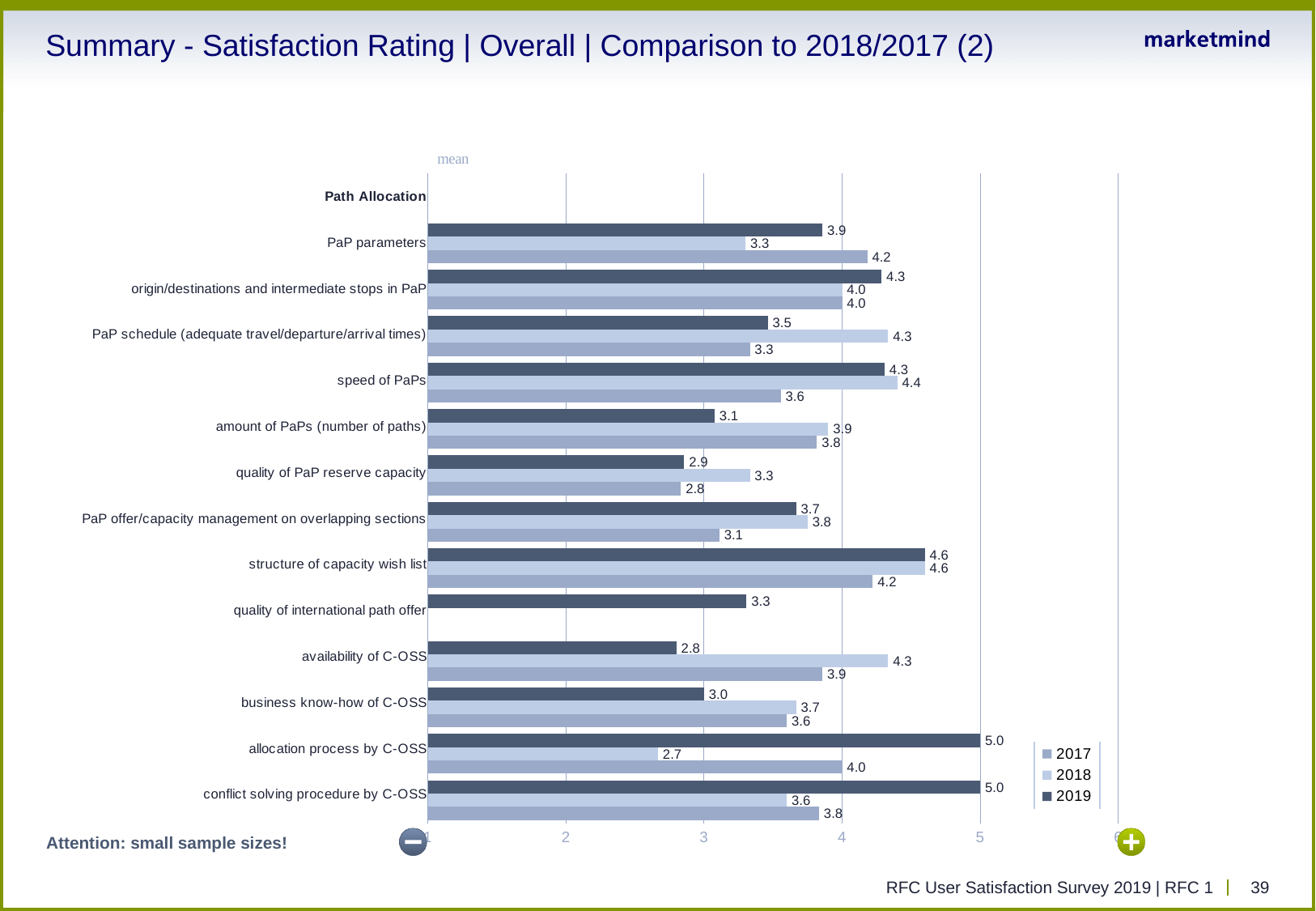
How many series does the legend list? 3 What kind of chart is shown on the slide? bar chart What is the 2017 value for PaP parameters? 4.2 What is the 2019 value for allocation process by C-OSS? 5.0 What is the difference between the 2018 and 2019 values for availability of C-OSS? 1.5 What is the difference between the 2019 and 2018 values for allocation process by C-OSS? 2.3 What is the 2018 value for PaP schedule (adequate travel/departure/arrival times)? 4.3 Which years are listed in the chart legend? 2017, 2018, 2019 Which category has the lowest 2019 value? availability of C-OSS Which category has the lowest 2018 value? allocation process by C-OSS What is the 2019 value for quality of international path offer? 3.3 Which is larger for amount of PaPs (number of paths): the 2018 value or the 2019 value? 2018